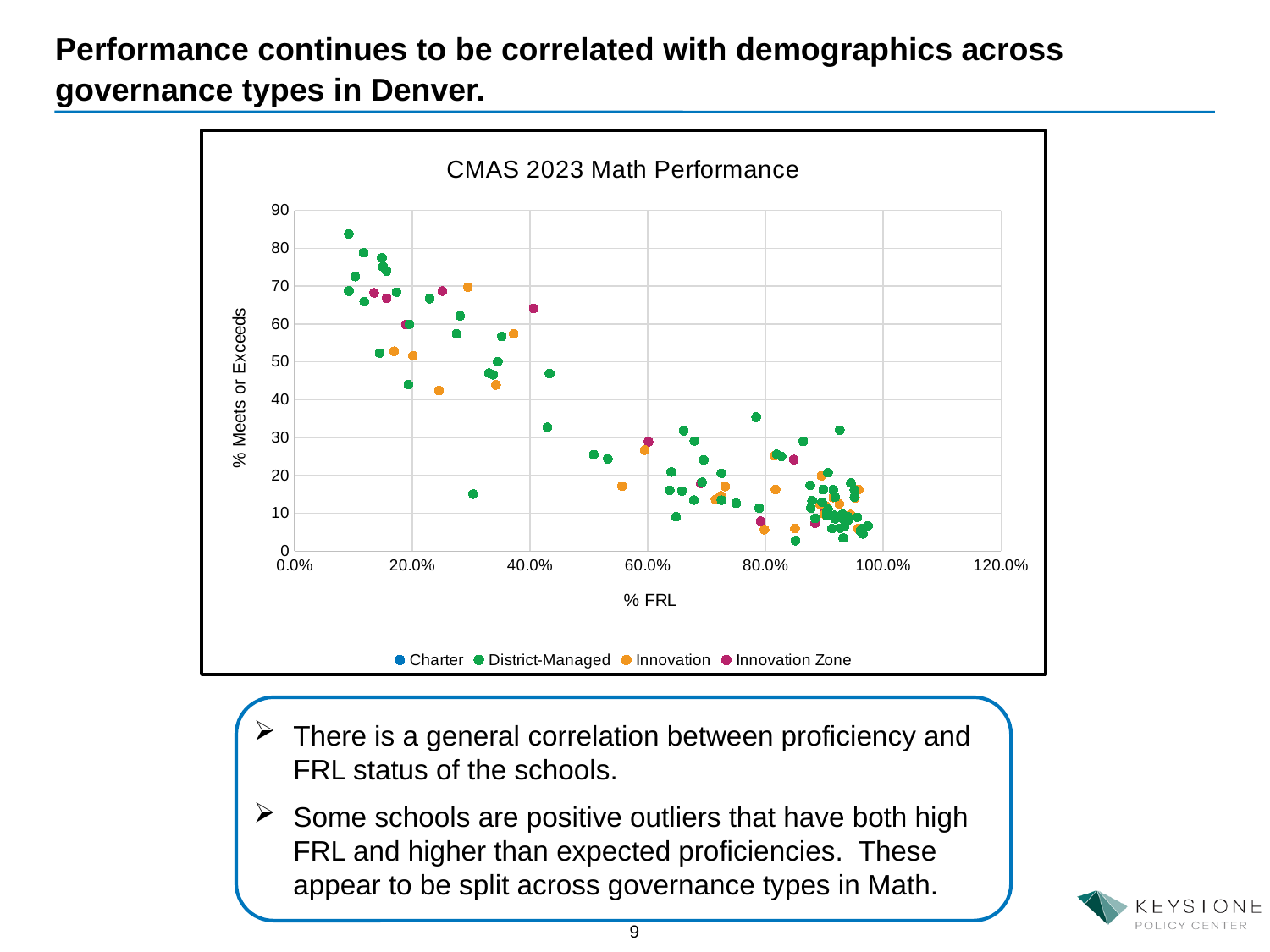
What kind of chart is shown on the slide? Scatter plot Is the lowest % Meets or Exceeds value plotted on the chart greater or less than 10? less Do any points on the chart exceed 90 on the % Meets or Exceeds axis? No How many series does the chart's legend list? 4 What is the label of the chart's x axis? % FRL What is the title of the chart? CMAS 2023 Math Performance As % FRL increases along the x axis, do the % Meets or Exceeds values generally rise or fall? Fall Is the highest % Meets or Exceeds value plotted on the chart greater or less than 80? greater